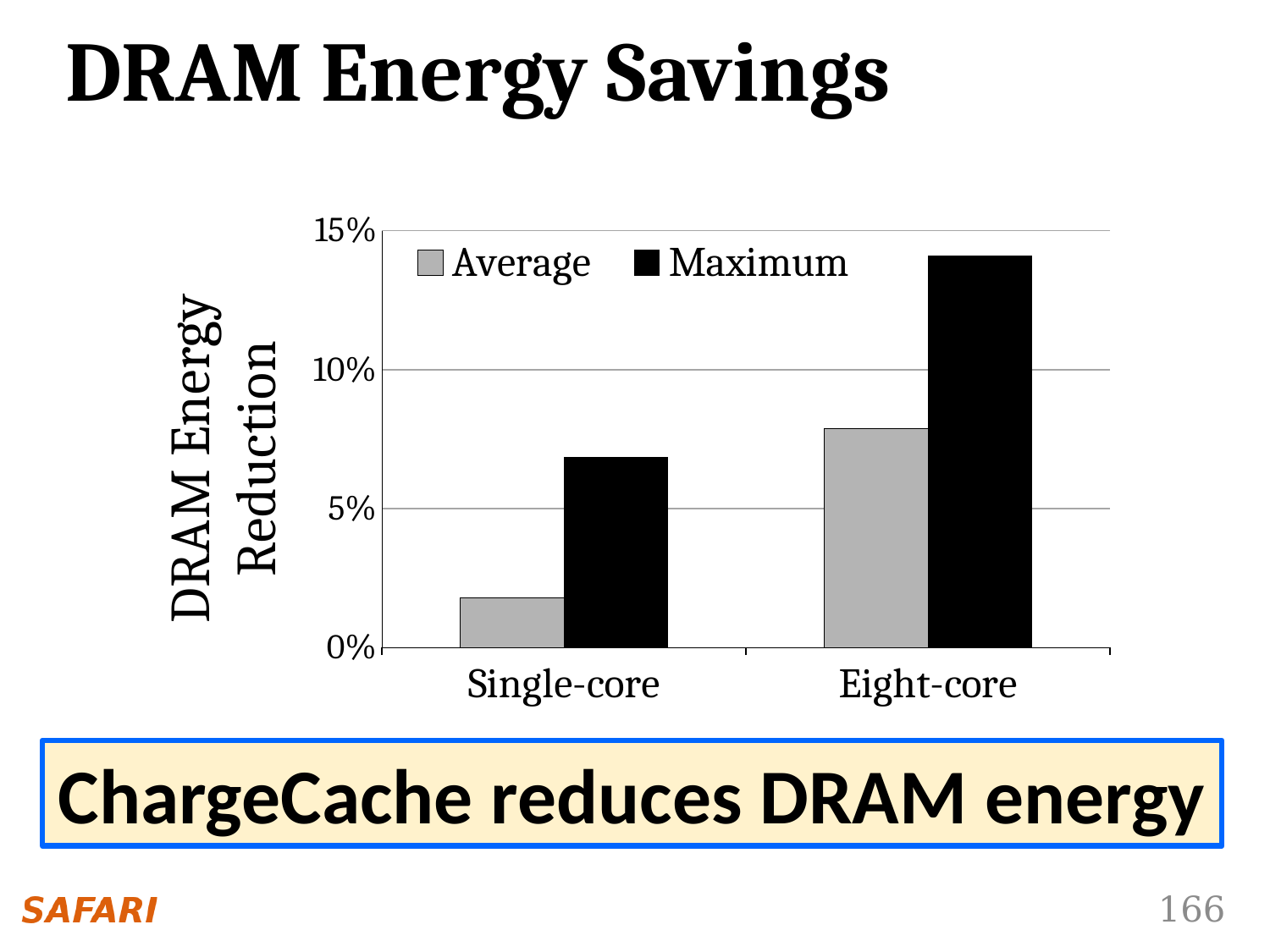
What is the label on the y axis of the chart? DRAM Energy Reduction Which category has the highest Maximum DRAM energy reduction? Eight-core Which category has the lowest Average DRAM energy reduction? Single-core Is the Average value for Eight-core greater or less than 10%? less Which is larger, the Average value for Eight-core or the Average value for Single-core? Eight-core Is the Maximum value for Eight-core greater or less than 10%? greater Is the Average value for Single-core greater or less than 5%? less Do the Maximum values rise or fall from Single-core to Eight-core? rise How many series does the legend list? 2 What kind of chart is shown on the slide? bar chart How many categories are shown on the x axis? 2